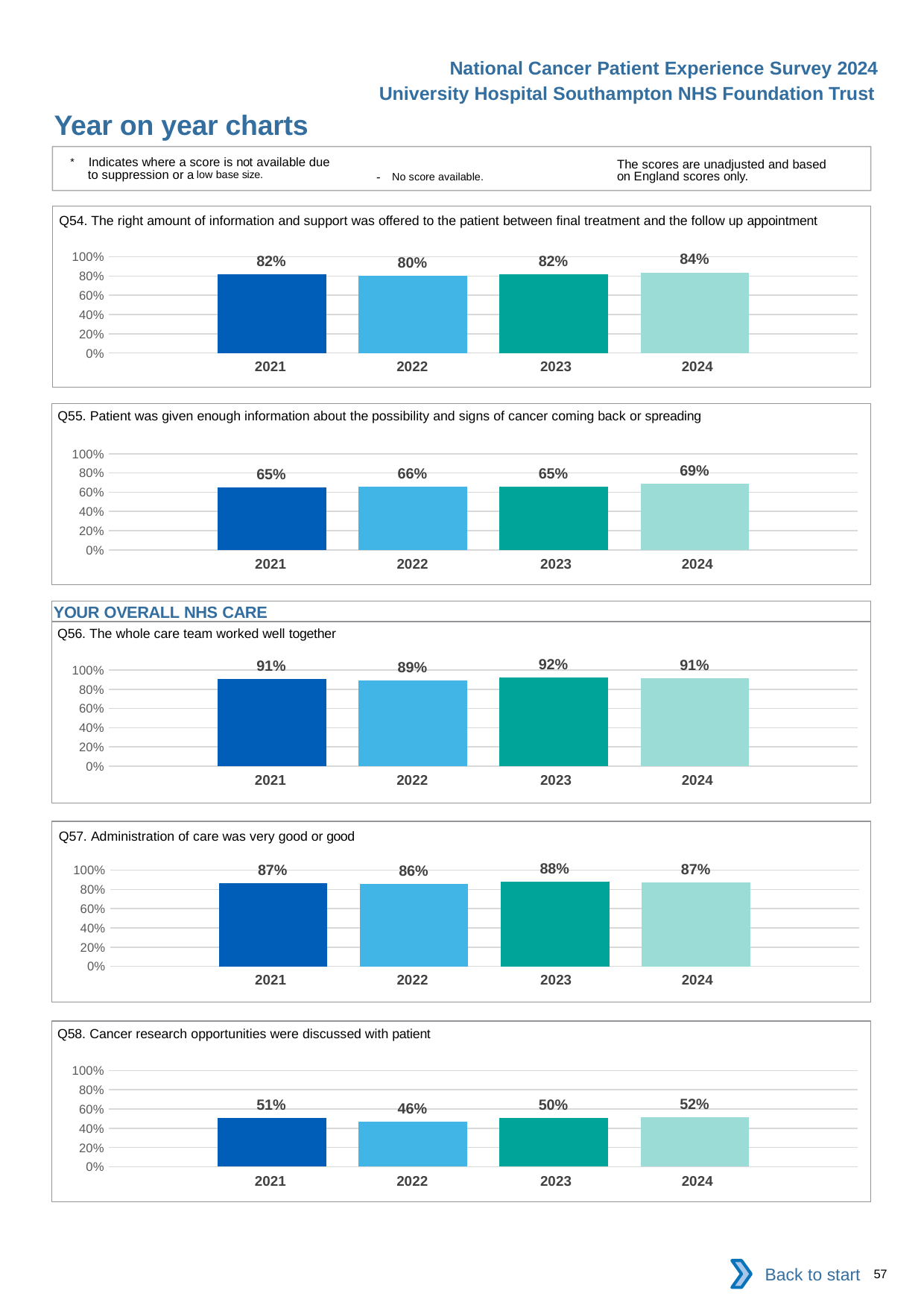
How many years are shown in the Q55 chart? 4 In the Q58 chart, what is the value for 2023? 50% What kind of chart is the Q56 chart? bar chart In the Q56 chart, which year has the lowest value? 2022 In the Q54 chart, what is the value for 2024? 84% In the Q57 chart, what is the difference between the 2023 and 2022 values? 2% In the Q55 chart, what is the difference between the 2024 and 2021 values? 4% How many charts are shown on the slide? 5 In the Q55 chart, which year has the highest value? 2024 In the Q58 chart, which is larger, the value for 2021 or the value for 2022? 2021 In the Q54 chart, which year has the lowest value? 2022 In the Q58 chart, is the value for 2022 greater or less than 60%? less